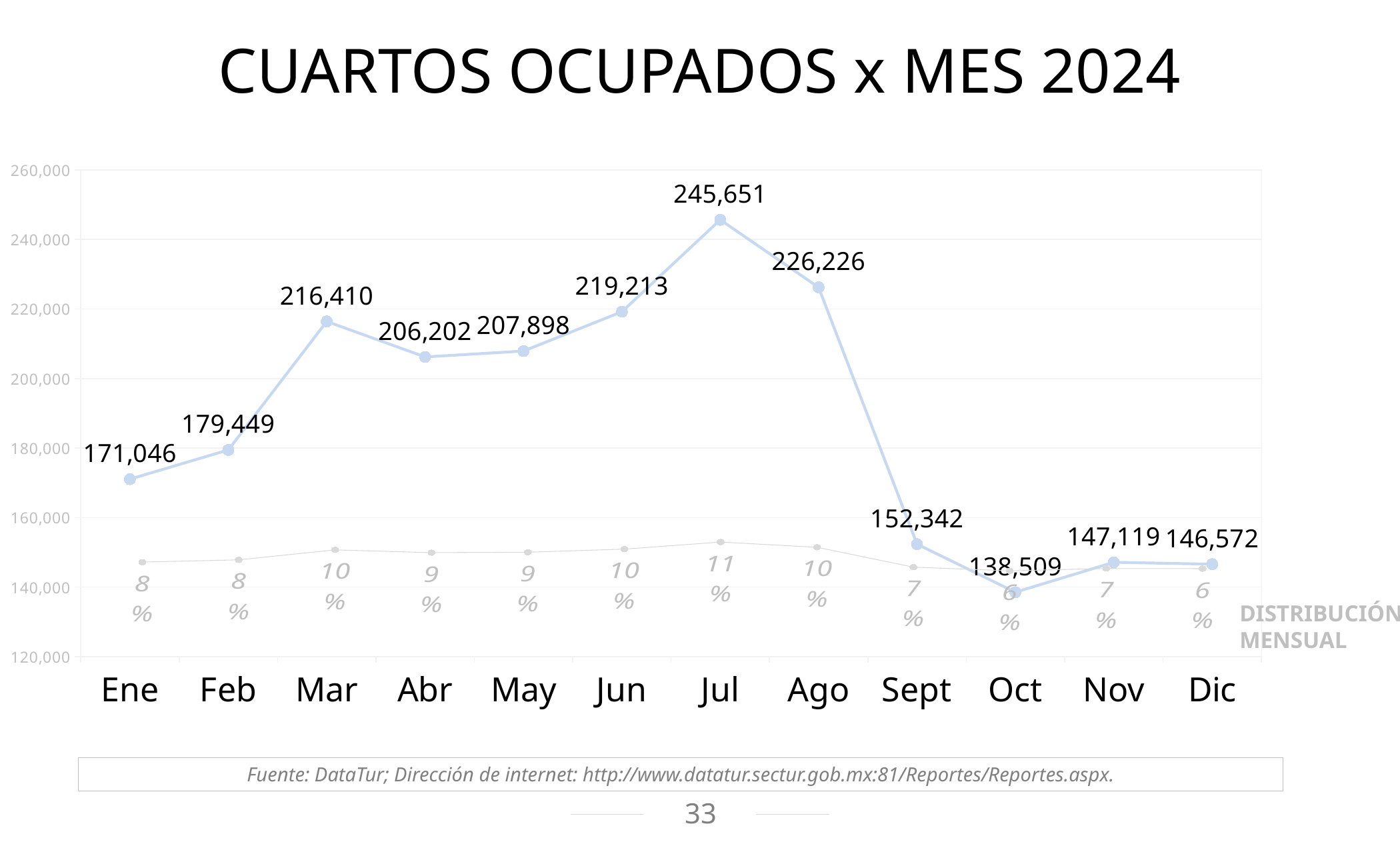
What is the difference between the values for Jul and Oct? 107,142 Which month has a larger value, Jun or Ago? Ago What percentage of the distribución mensual does Jul represent? 11% What is the difference between the values for Mar and Feb? 36,961 What is the number of cuartos ocupados for Oct? 138,509 What kind of chart is shown on the slide? line chart Which month has the highest number of cuartos ocupados? Jul What is the value shown for Mar? 216,410 Which month has the lowest number of cuartos ocupados? Oct Is the value for Ene greater or less than 180,000? less How many months are plotted on the x axis? 12 What is the number of cuartos ocupados for Jul? 245,651